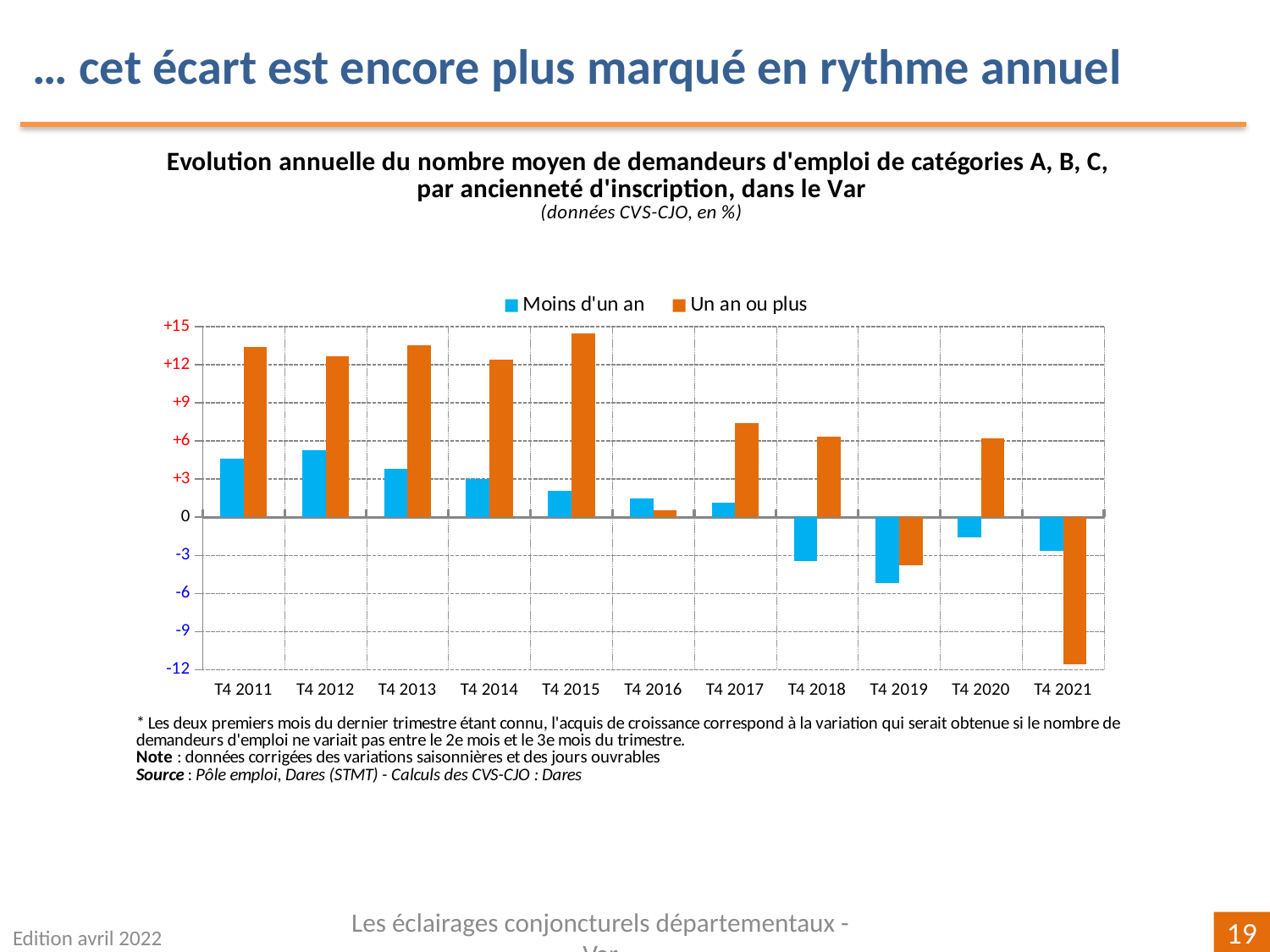
In which quarter is the value for 'Un an ou plus' the highest? T4 2015 Is the value for 'Un an ou plus' in T4 2021 greater or less than -9? less In T4 2016, which series has the larger value, 'Moins d'un an' or 'Un an ou plus'? Moins d'un an In T4 2020, which series has the larger value, 'Moins d'un an' or 'Un an ou plus'? Un an ou plus Is the value for 'Moins d'un an' in T4 2018 greater or less than 0? less How many quarters (categories) are shown on the x axis? 11 In which quarter is the value for 'Un an ou plus' the lowest? T4 2021 Is the value for 'Un an ou plus' in T4 2017 greater or less than 6? greater How many series does the legend list? 2 What colour represents the 'Un an ou plus' series in the legend? orange In which quarter is the value for 'Moins d'un an' the lowest? T4 2019 What kind of chart is shown on the slide? bar chart